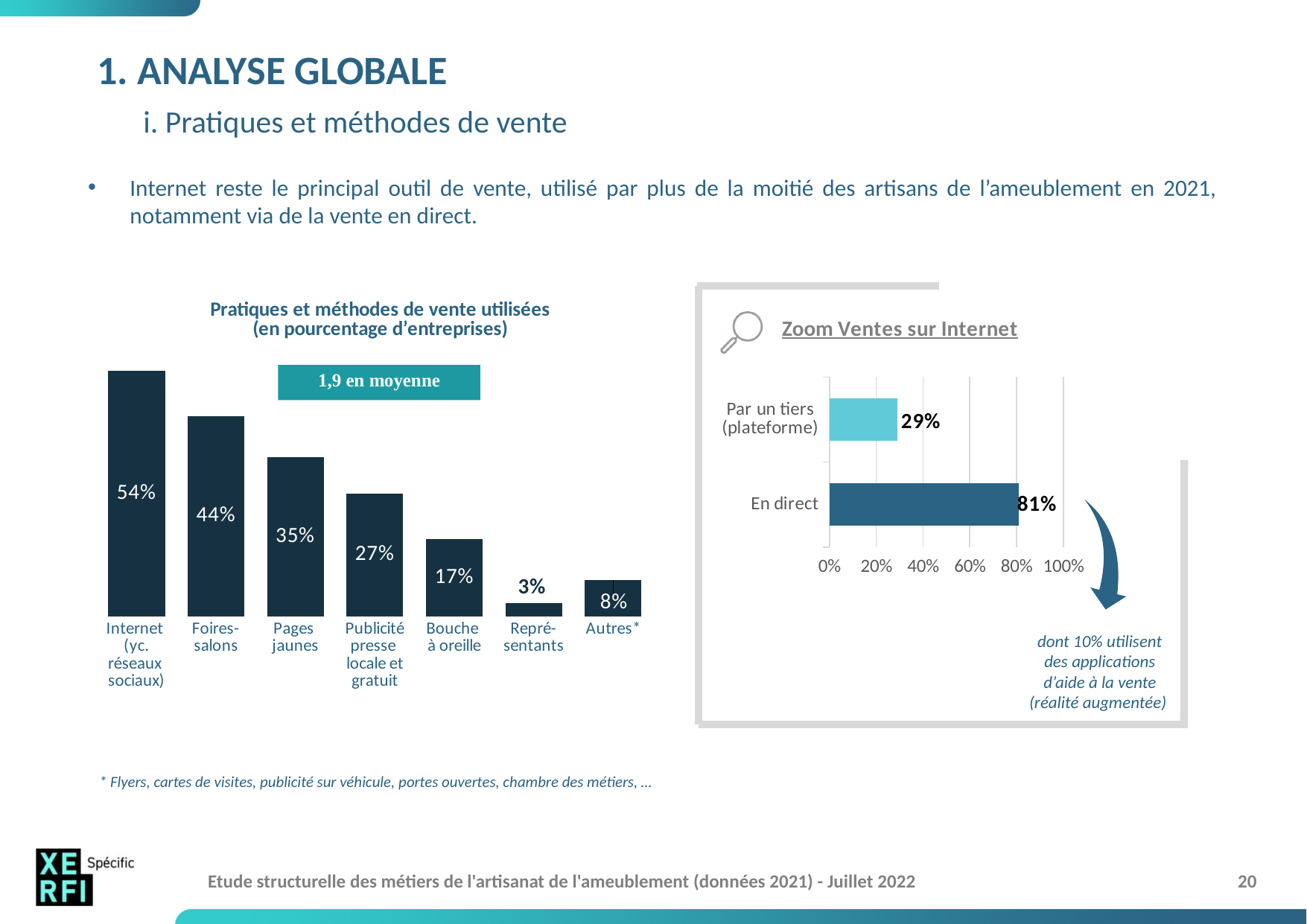
In the chart 'Pratiques et méthodes de vente utilisées', what is the value for Bouche à oreille? 17% In the chart 'Pratiques et méthodes de vente utilisées', which category has the highest value? Internet (yc. réseaux sociaux) How many categories are shown in the chart 'Pratiques et méthodes de vente utilisées'? 7 In the chart 'Pratiques et méthodes de vente utilisées', which category has the lowest value? Représentants In the chart 'Pratiques et méthodes de vente utilisées', what is the value for Foires-salons? 44% What average value is shown in the box on the chart 'Pratiques et méthodes de vente utilisées'? 1,9 en moyenne In the chart 'Pratiques et méthodes de vente utilisées', which is larger: Publicité presse locale et gratuit or Autres? Publicité presse locale et gratuit In the 'Zoom Ventes sur Internet' chart, what is the difference between En direct and Par un tiers (plateforme)? 52% In the 'Zoom Ventes sur Internet' chart, what is the value for En direct? 81% What kind of chart is 'Pratiques et méthodes de vente utilisées'? Bar chart In the chart 'Pratiques et méthodes de vente utilisées', what is the difference between Internet (yc. réseaux sociaux) and Pages jaunes? 19% In the 'Zoom Ventes sur Internet' chart, what is the value for Par un tiers (plateforme)? 29%